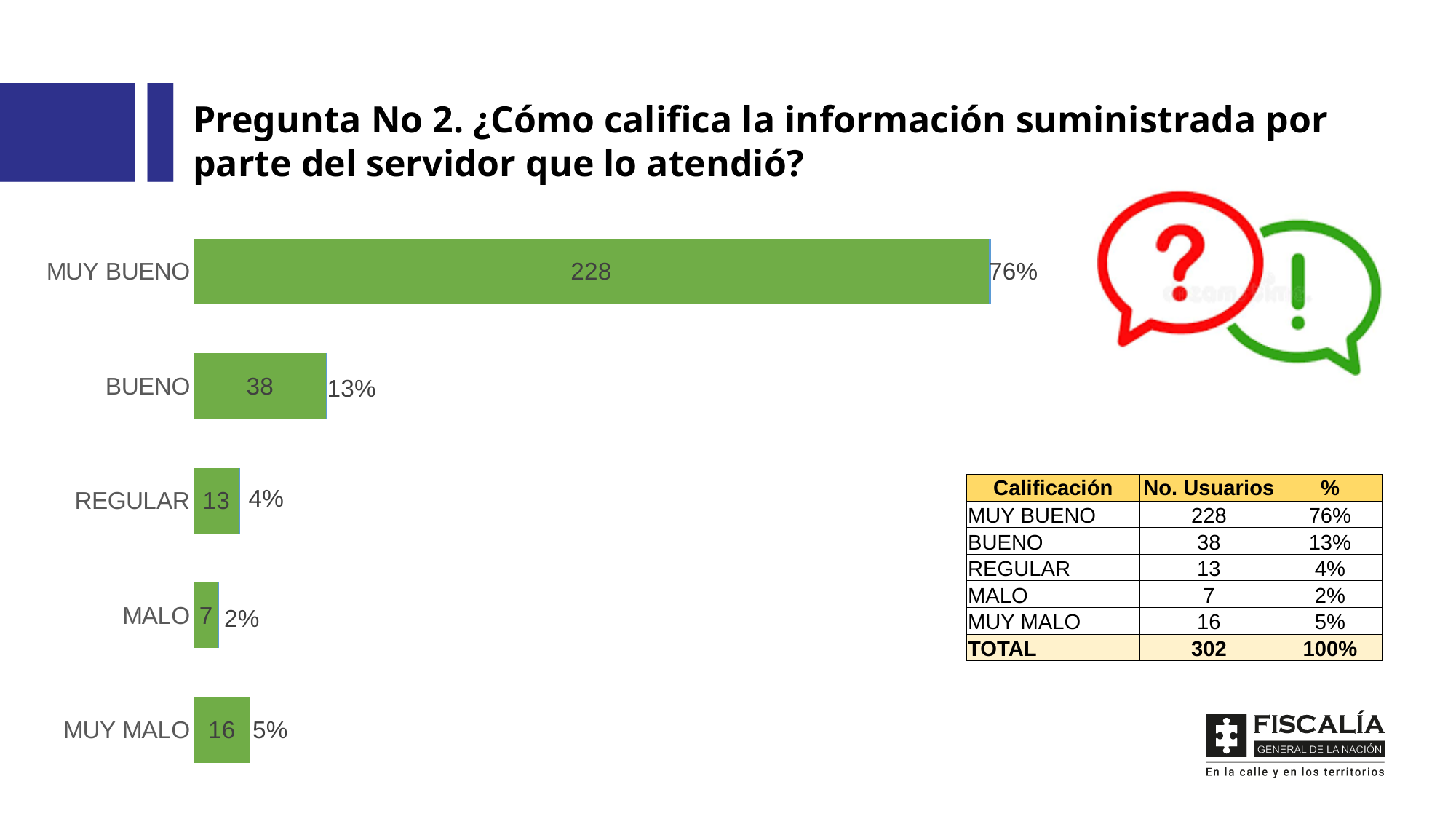
Which category has the highest number of users? MUY BUENO What is the number of users who rated the information as MUY BUENO? 228 Which has more users, MUY MALO or REGULAR? MUY MALO What colour are the bars in the chart? Green What is the difference in users between MUY BUENO and BUENO? 190 What percentage of users rated the information as BUENO? 13% What percentage is shown for MUY MALO? 5% What is the total number of users across all categories? 302 Which category has the lowest number of users? MALO What kind of chart is shown on the slide? Bar chart How many categories are shown in the bar chart? 5 What is the value shown for REGULAR? 13